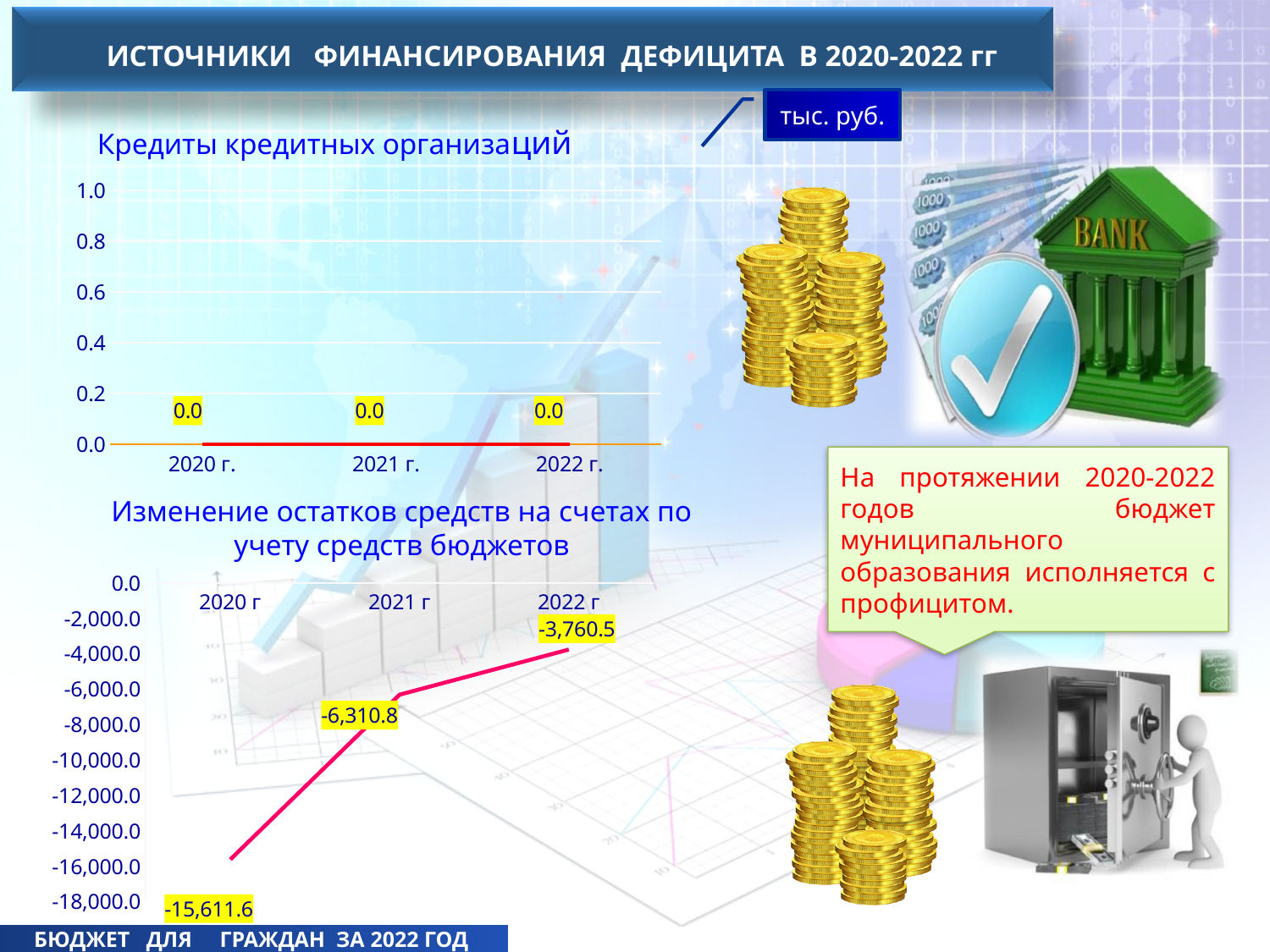
In the chart titled "Изменение остатков средств на счетах по учету средств бюджетов", is the value for 2021 г greater or less than -8,000.0? greater In the chart titled "Изменение остатков средств на счетах по учету средств бюджетов", what is the difference between the values for 2021 г and 2022 г? 2,550.3 In the chart titled "Изменение остатков средств на счетах по учету средств бюджетов", which year has the lowest value? 2020 г In the chart titled "Изменение остатков средств на счетах по учету средств бюджетов", do the values rise or fall from 2020 г to 2022 г? rise In the chart titled "Изменение остатков средств на счетах по учету средств бюджетов", what is the value for 2020 г? -15,611.6 What unit is indicated for the charts on the slide? тыс. руб. In the chart titled "Изменение остатков средств на счетах по учету средств бюджетов", which year has the highest value? 2022 г In the chart titled "Кредиты кредитных организаций", what is the value for 2021 г.? 0.0 In the chart titled "Кредиты кредитных организаций", how many years are plotted? 3 In the chart titled "Изменение остатков средств на счетах по учету средств бюджетов", what is the value for 2021 г? -6,310.8 What kind of chart is the chart titled "Кредиты кредитных организаций"? line chart In the chart titled "Изменение остатков средств на счетах по учету средств бюджетов", what is the value for 2022 г? -3,760.5